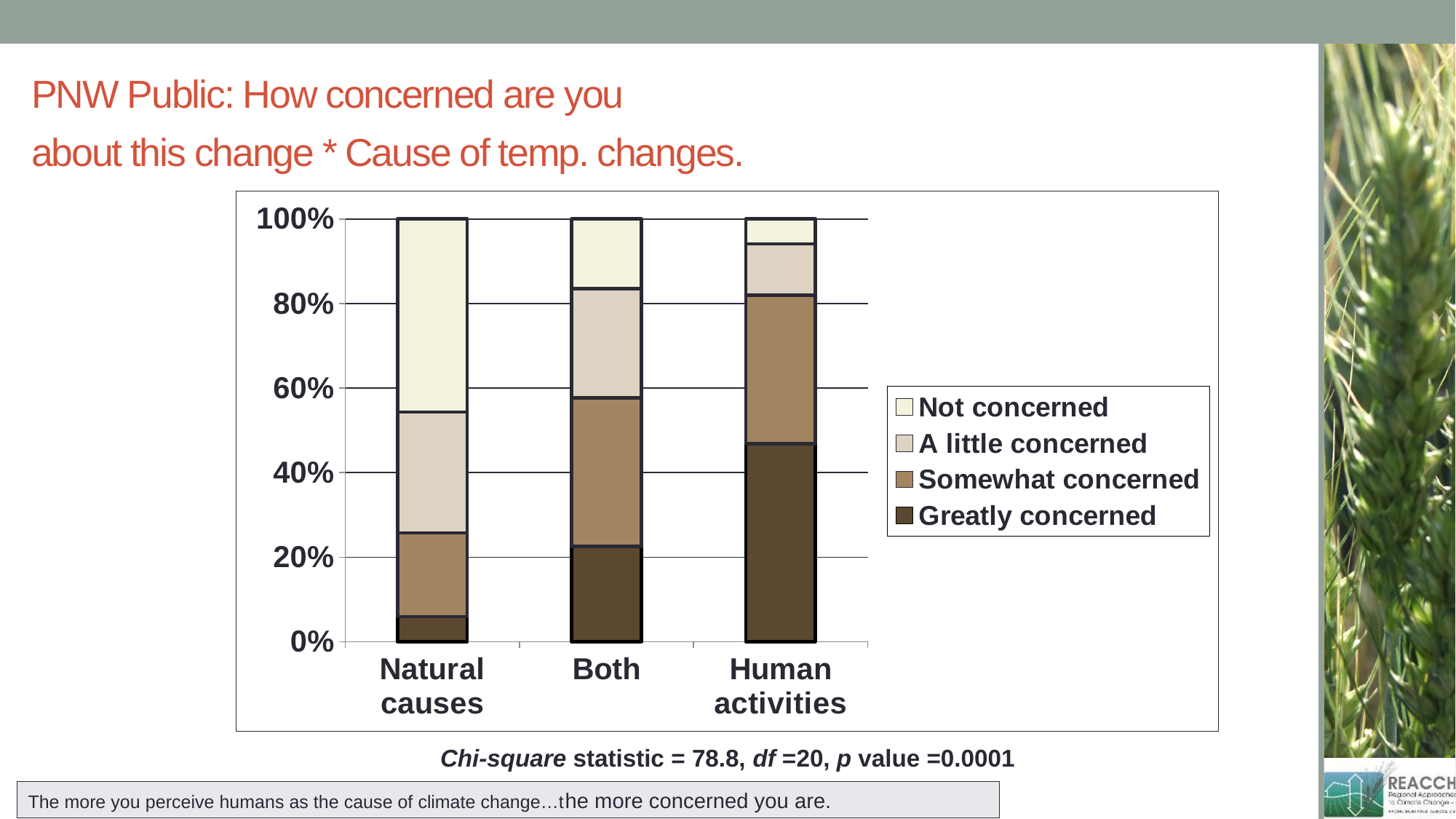
What kind of chart is shown on the slide? stacked bar chart Which category has the largest Not concerned share? Natural causes Is the Greatly concerned share for Natural causes greater or less than 20%? less Which category has the smallest Greatly concerned share? Natural causes Is the Greatly concerned share for Human activities greater or less than 40%? greater What is the chi-square statistic printed below the chart? 78.8 How many series does the chart's legend list? 4 Is the Greatly concerned share larger for Both or for Natural causes? Both What is the total height of the Natural causes stacked bar? 100% Is the Greatly concerned share for Both greater or less than 40%? less Which category has the largest Greatly concerned share? Human activities How many categories are shown on the x axis of the chart? 3